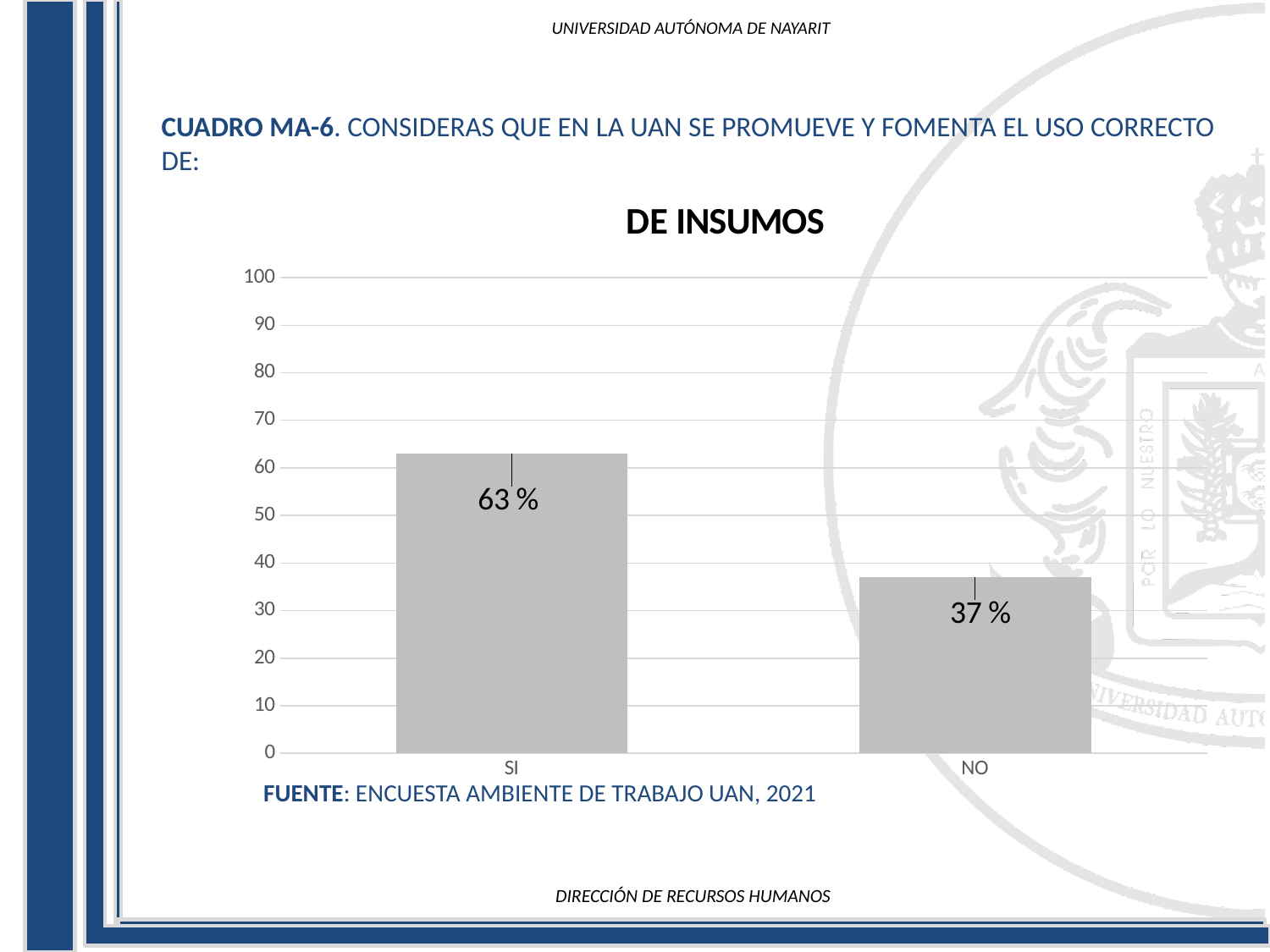
Which is larger, the value for SI or the value for NO? SI How many categories are shown on the x axis? 2 What is the maximum value shown on the vertical axis? 100 Is the value for SI greater or less than 60? greater What kind of chart is shown on the slide? bar chart Which category has the highest value? SI What is the difference between the values for SI and NO? 26 % What is the title of the chart? DE INSUMOS Which category has the lowest value? NO What is the value for SI? 63 % Is the value for NO greater or less than 40? less What is the value for NO? 37 %